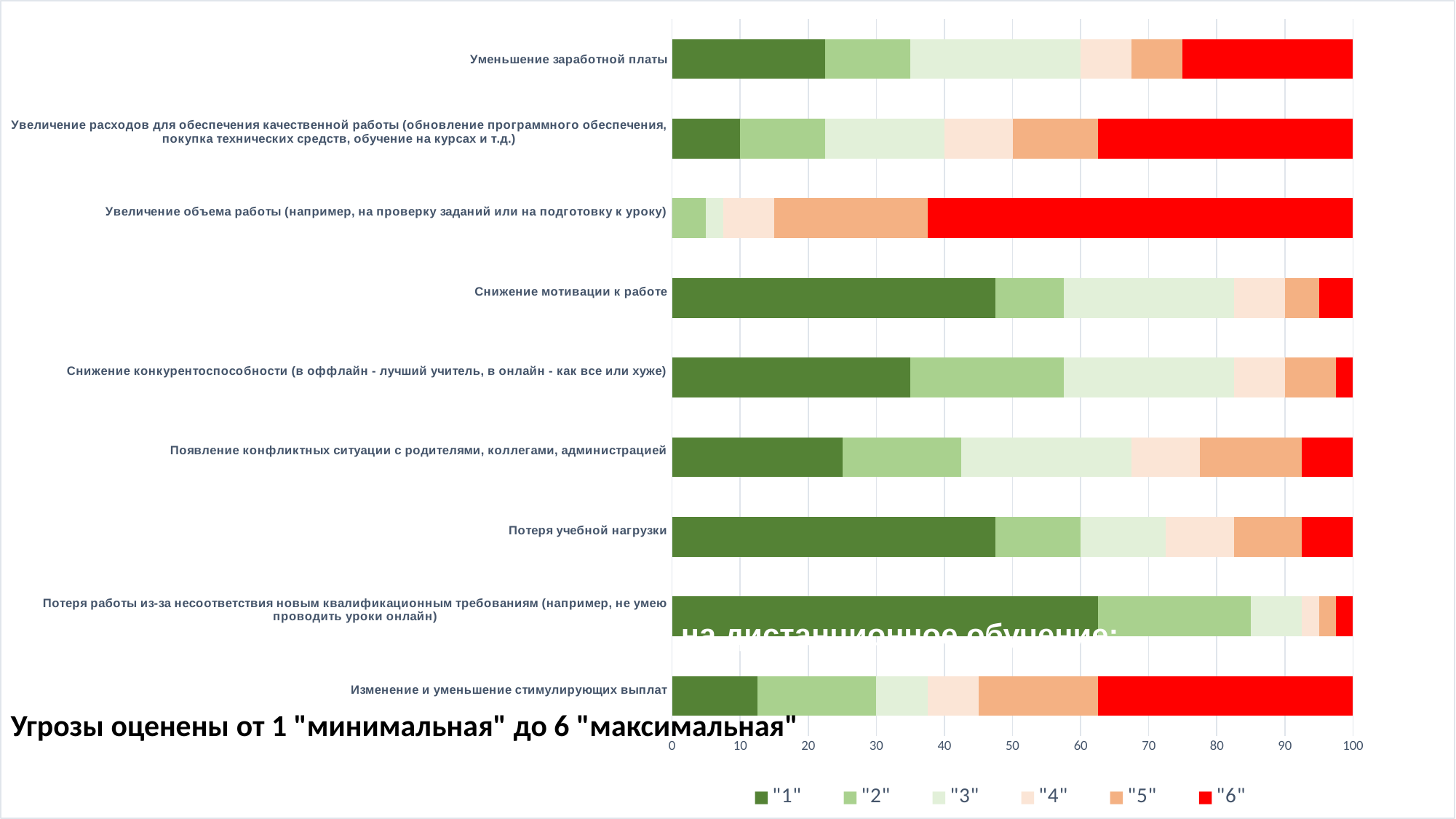
How many series does the legend list? 6 Which has the larger share of series "1": "Снижение мотивации к работе" or "Снижение конкурентоспособности"? Снижение мотивации к работе Is the share of series "1" for "Снижение мотивации к работе" greater or less than 50? less Is the share of series "1" for "Потеря работы из-за несоответствия новым квалификационным требованиям" greater or less than 60? greater What kind of chart is shown on the slide? Stacked bar chart What is the total of the stacked bar for "Уменьшение заработной платы"? 100 Which category has the largest share for series "1"? Потеря работы из-за несоответствия новым квалификационным требованиям (например, не умею проводить уроки онлайн) What are the series names listed in the legend? "1", "2", "3", "4", "5", "6" What colour represents the series "6" in the chart? Red Is the share of series "6" for "Увеличение объема работы" greater or less than 60? greater How many categories (threats) are plotted on the chart? 9 Which category has the largest share for series "6"? Увеличение объема работы (например, на проверку заданий или на подготовку к уроку)